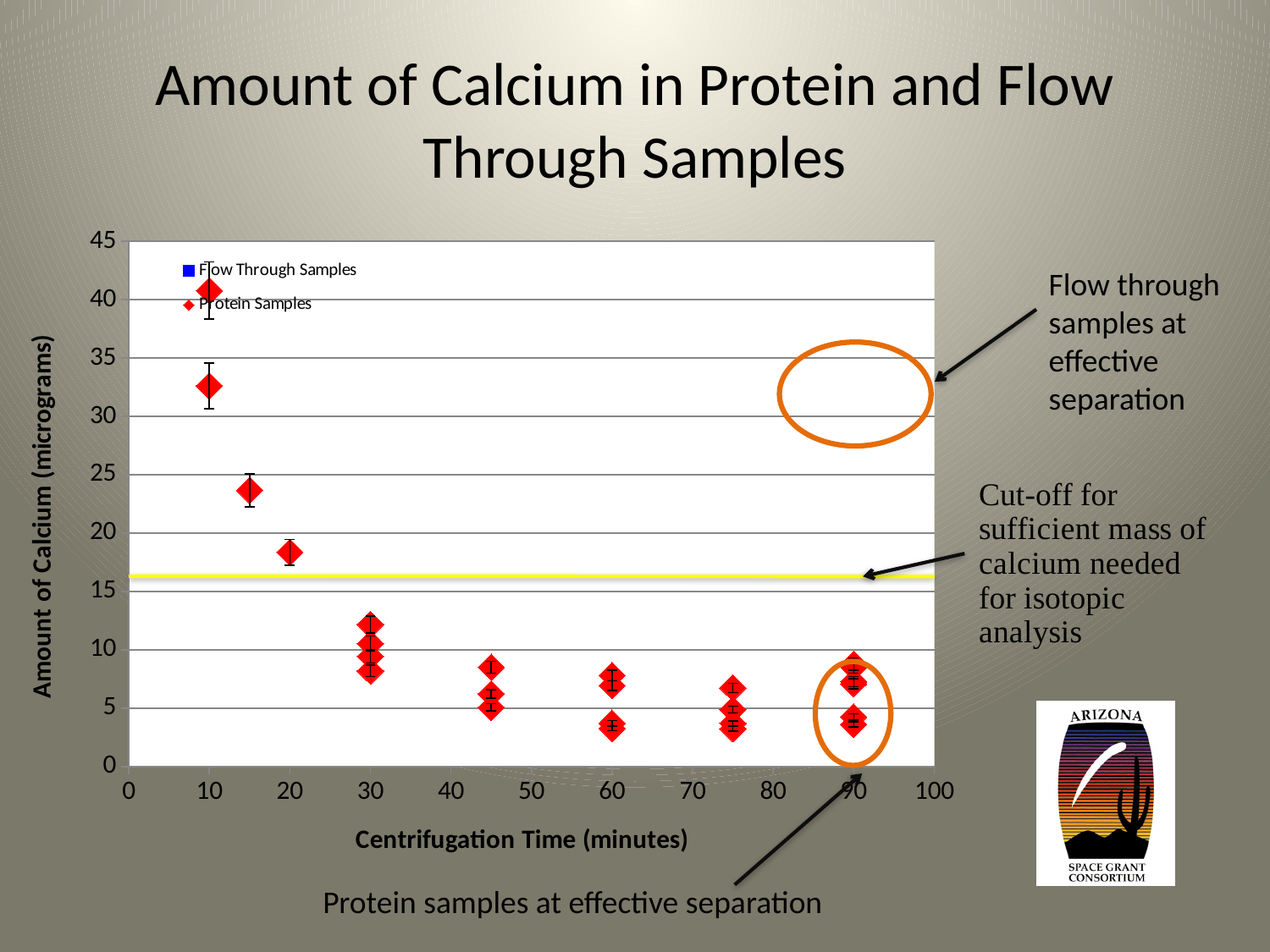
What are the two series named in the chart legend? Flow Through Samples and Protein Samples How many series does the chart legend list? 2 Are the Protein Samples values at 90 minutes greater or less than 10? less Are the Protein Samples values at 45 minutes greater or less than 10? less What kind of chart is shown on the slide? Scatter chart What is the label of the x axis of the chart? Centrifugation Time (minutes) Is the Protein Samples value at 20 minutes greater or less than 15? greater Do the Protein Samples values generally rise or fall as centrifugation time increases? Fall Which has the larger Protein Samples value, 20 minutes or 30 minutes? 20 minutes At which centrifugation time is the highest Protein Samples value plotted? 10 minutes